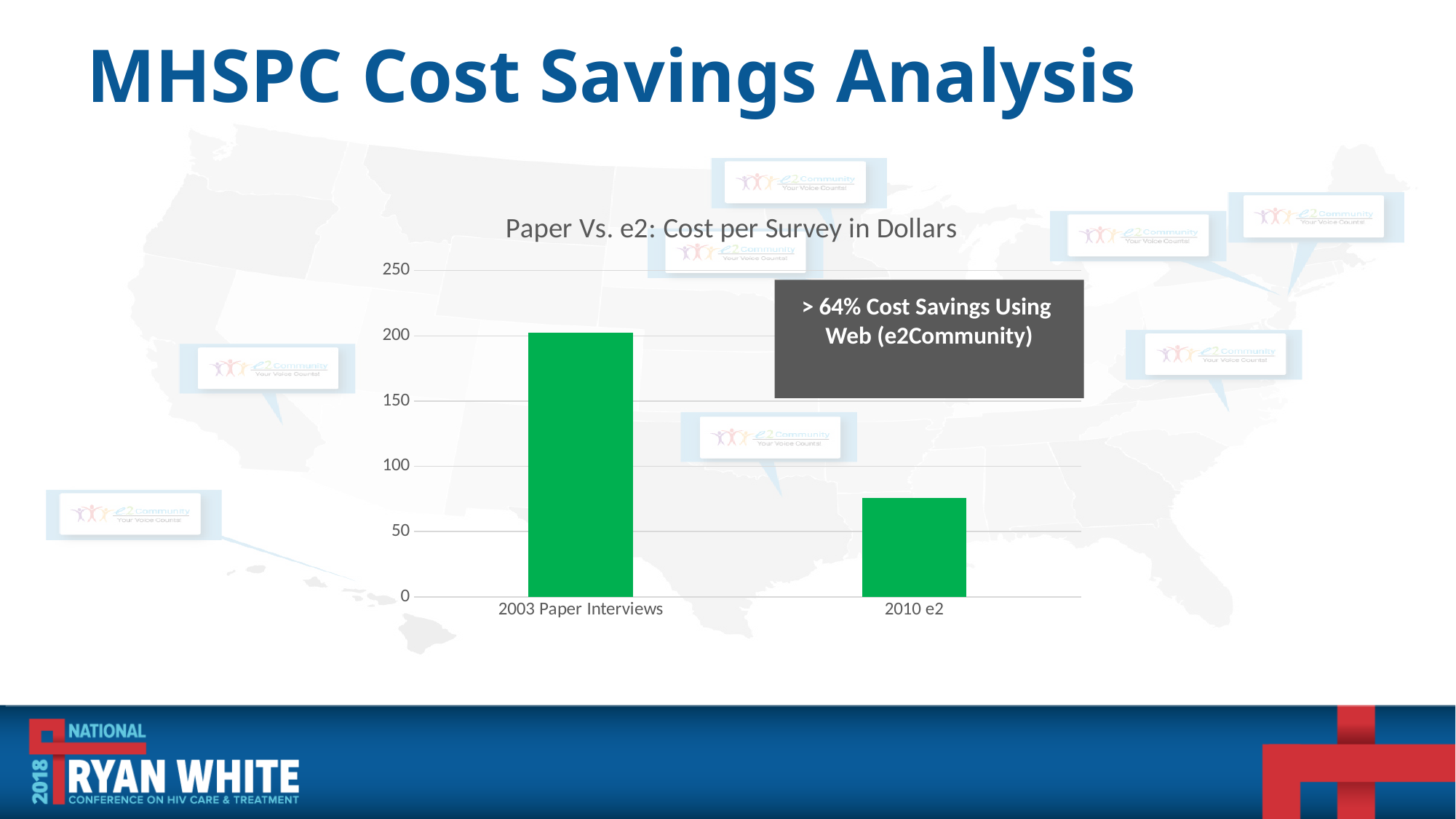
What cost savings percentage does the text box on the chart state for using Web (e2Community)? > 64% Which category has the lowest cost per survey? 2010 e2 Is the value for 2010 e2 greater or less than 100? less What is the highest value shown on the vertical axis of the chart? 250 How many categories are plotted in the chart? 2 Is the value for 2003 Paper Interviews greater or less than 150? greater Which is larger, the cost per survey for 2003 Paper Interviews or for 2010 e2? 2003 Paper Interviews Is the value for 2010 e2 greater or less than 50? greater Do the values rise or fall from 2003 Paper Interviews to 2010 e2? fall What is the title of the chart? Paper Vs. e2: Cost per Survey in Dollars Which category has the highest cost per survey? 2003 Paper Interviews What type of chart is shown on the slide? Bar chart